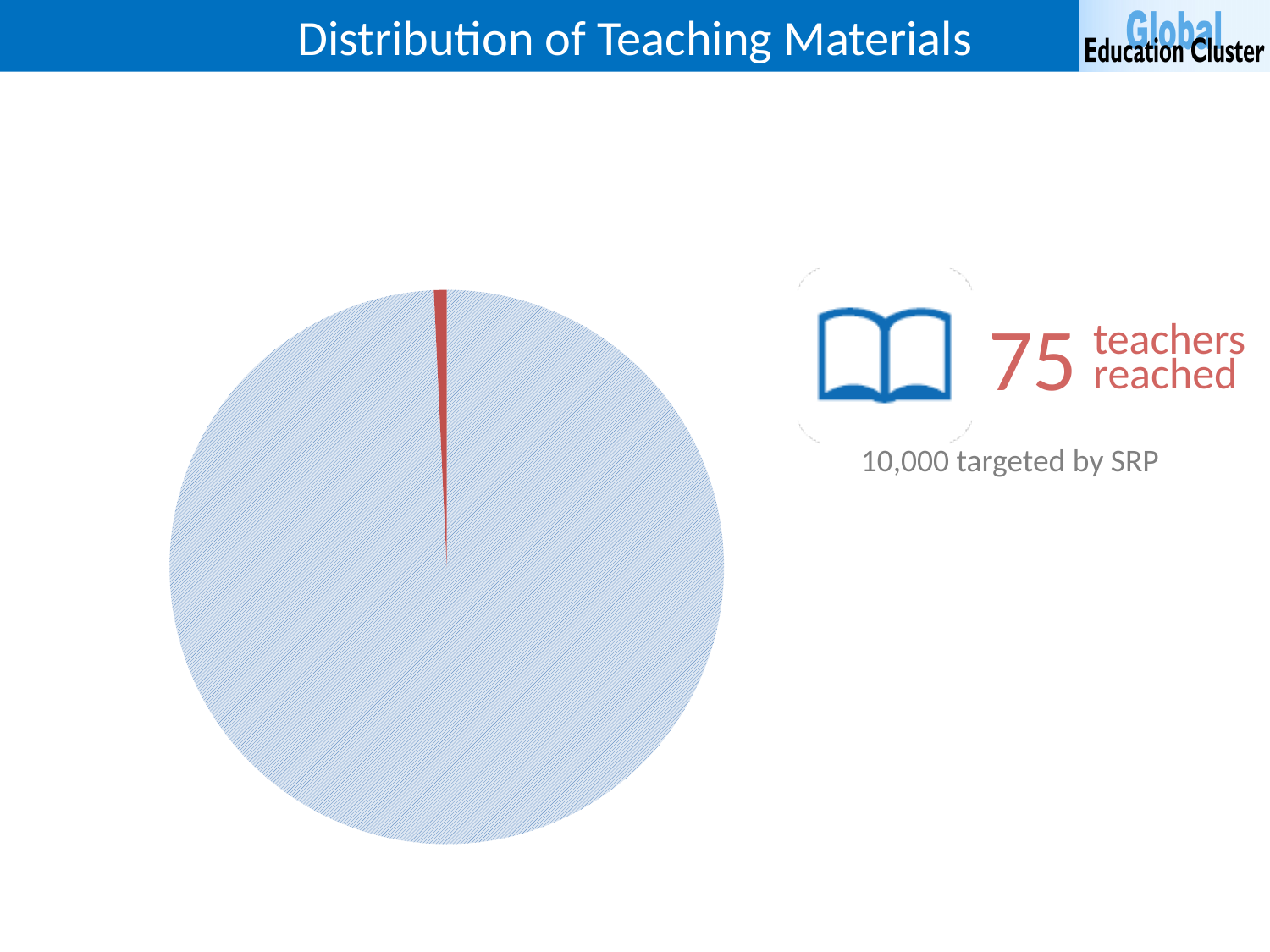
What kind of chart is shown on the slide? pie chart Which colour slice is the largest in the pie chart? blue Which colour slice is the smallest in the pie chart? red How many slices does the pie chart have? 2 Does the pie chart display a legend? No Which slice of the pie chart is larger, the blue slice or the red slice? the blue slice What is the title shown at the top of the slide above the pie chart? Distribution of Teaching Materials